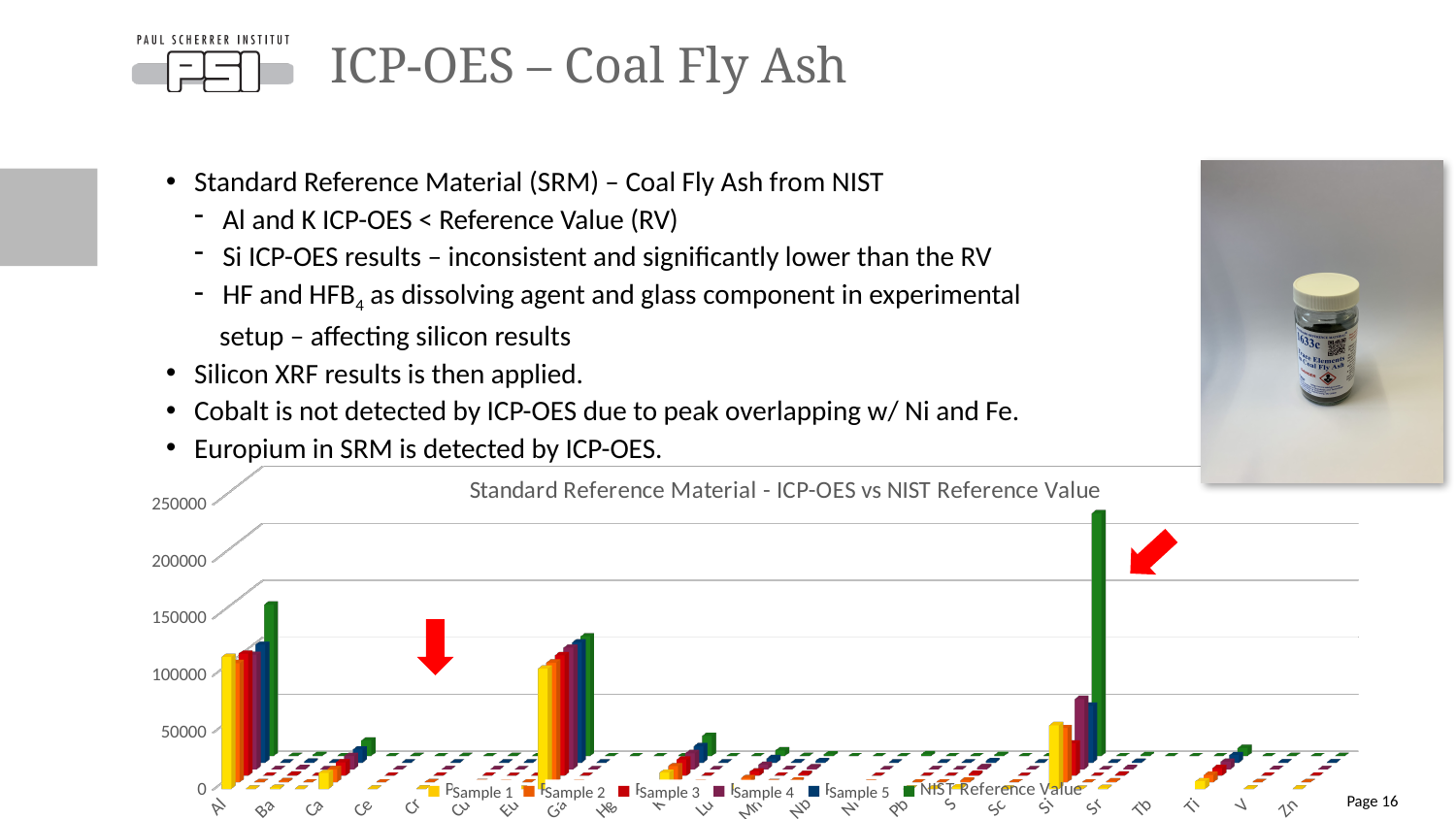
Which is larger, the NIST Reference Value for Si or the NIST Reference Value for Al? Si How many series does the chart legend list? 6 For Si, which is larger, the Sample 1 value or the NIST Reference Value? NIST Reference Value Which series is shown in green in the chart legend? NIST Reference Value Which element has the tallest bar in the chart? Si Is the NIST Reference Value for K greater or less than 50000? less What type of chart is shown on the slide? bar chart Is the NIST Reference Value for Al greater or less than 100000? greater What is the title of the chart? Standard Reference Material - ICP-OES vs NIST Reference Value Which is larger, the NIST Reference Value for Al or the NIST Reference Value for Ba? Al Is the NIST Reference Value for Ca greater or less than 50000? less